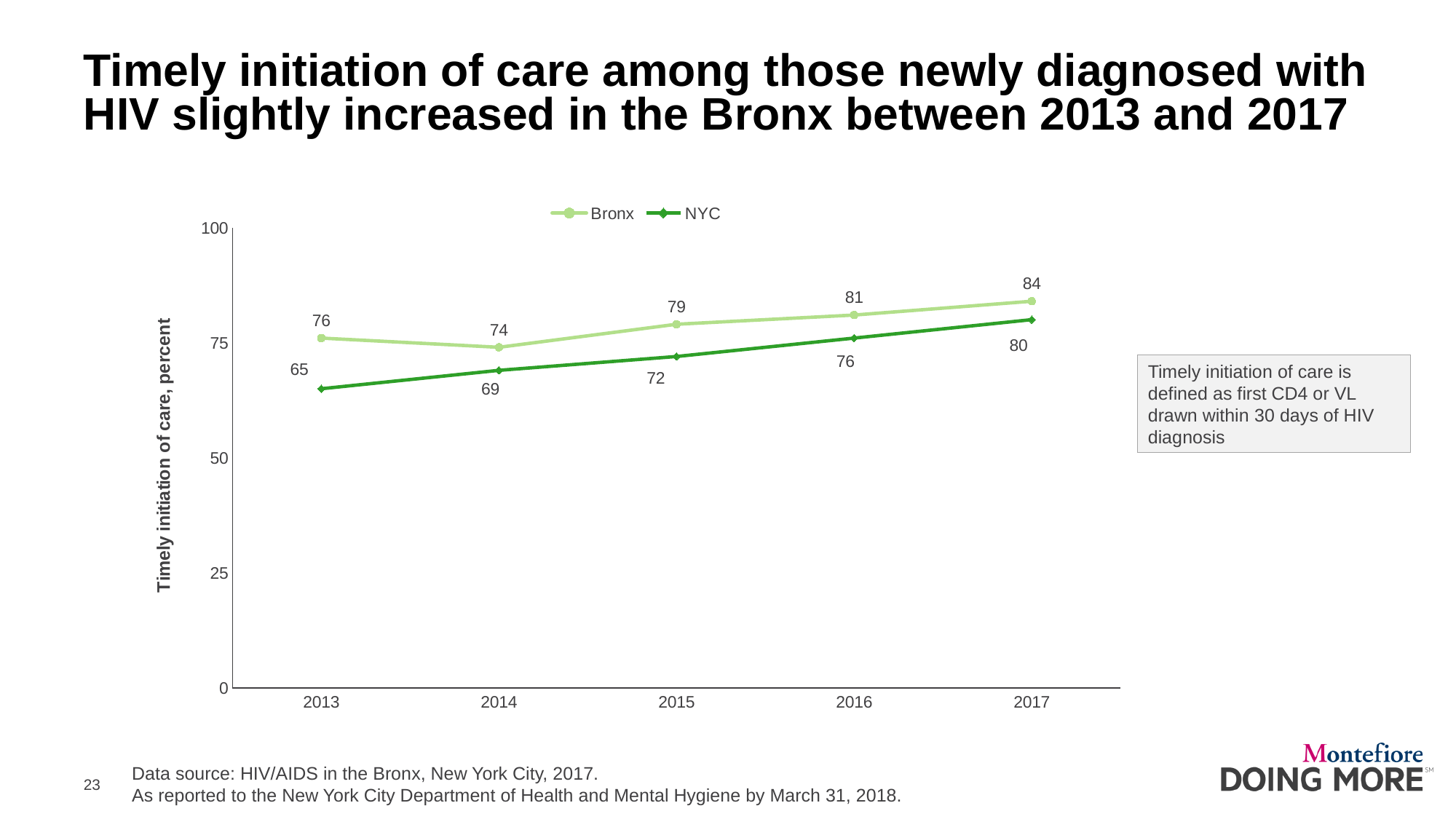
What kind of chart is shown on the slide? Line chart How many years are plotted on the x axis? 5 Which is larger in 2016, the Bronx value or the NYC value? Bronx In which year is the NYC value highest? 2017 How many series does the legend list? 2 What is the Bronx value for timely initiation of care in 2017? 84 What is the NYC value for timely initiation of care in 2013? 65 Does the NYC series rise or fall from 2013 to 2017? Rise In which year is the Bronx value lowest? 2014 By how much did the Bronx value increase from 2013 to 2017? 8 What is the difference between the Bronx and NYC values in 2013? 11 What is the Bronx value in 2014? 74